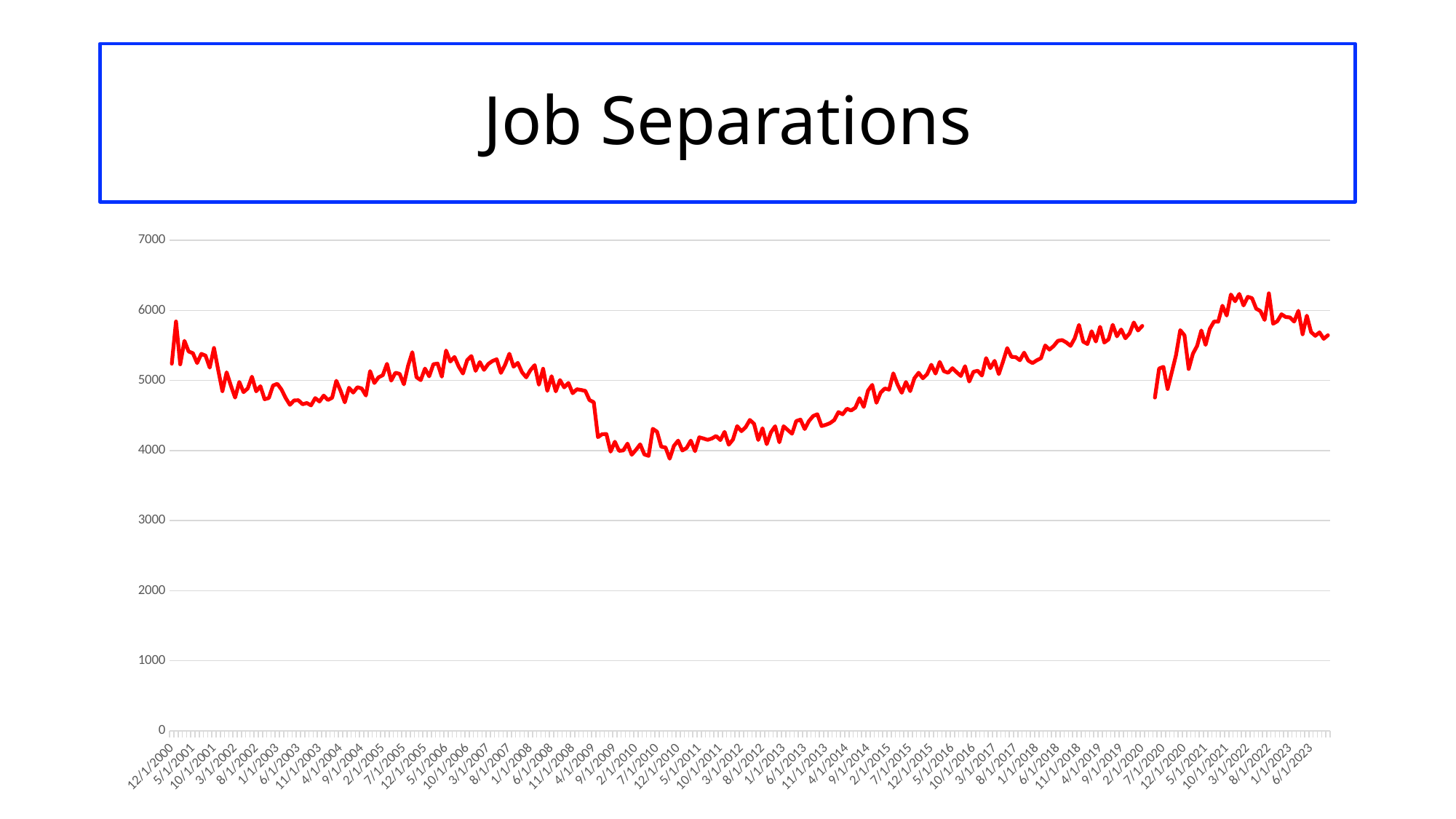
Is the value for 12/1/2000 greater or less than 5000? greater Which is larger, the value for 3/1/2022 or the value for 7/1/2010? 3/1/2022 How many data series are plotted on the chart? 1 Is the value for 6/1/2023 greater or less than 5000? greater What is the title of the chart? Job Separations Do the values rise or fall between 4/1/2009 and 2/1/2010? fall Is the value for 3/1/2022 greater or less than 6000? greater What kind of chart is shown on the slide? line chart What is the highest value shown on the vertical axis? 7000 Do the values rise or fall between 1/1/2013 and 9/1/2019? rise